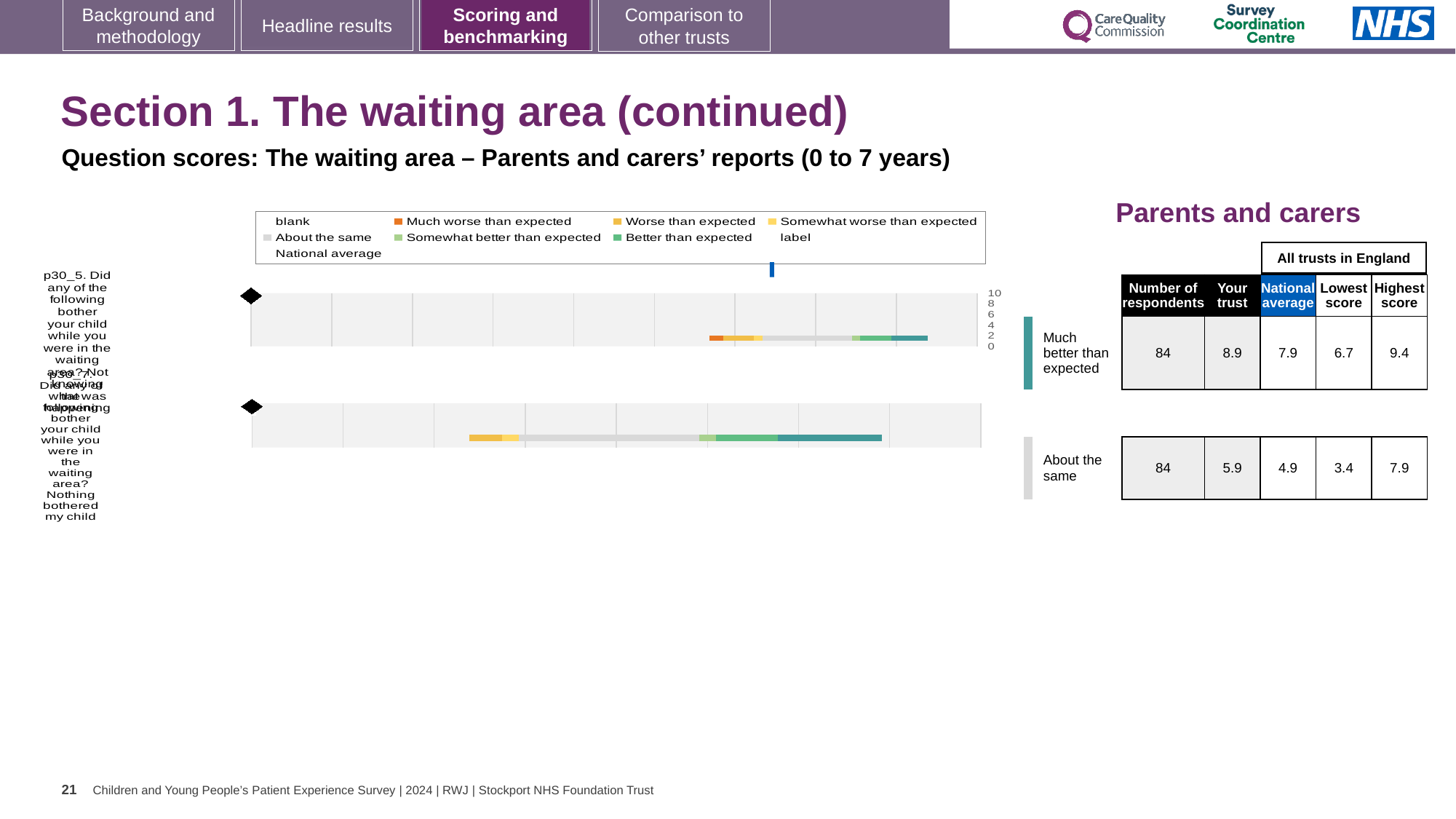
In the table beside the chart, what is the lowest score for the second question (p30_7)? 3.4 Which legend entry is shown in orange? Much worse than expected In the table beside the chart, what is the national average for the first question (p30_5)? 7.9 In the table beside the chart, what is the 'Your trust' score for the second question (p30_7, About the same)? 5.9 What kind of chart is shown on the slide? bar chart In the table beside the chart, how many respondents answered the first question (p30_5)? 84 In the table beside the chart, what is the 'Your trust' score for the first question (p30_5, Much better than expected)? 8.9 Which legend entry is shown in light grey? About the same In the table beside the chart, what is the difference between the 'Your trust' score and the national average for the first question (p30_5)? 1.0 In the table beside the chart, what is the highest score for the first question (p30_5)? 9.4 In the table beside the chart, which is larger for the second question (p30_7): the 'Your trust' score or the national average? Your trust How many question bars are plotted in the chart? 2